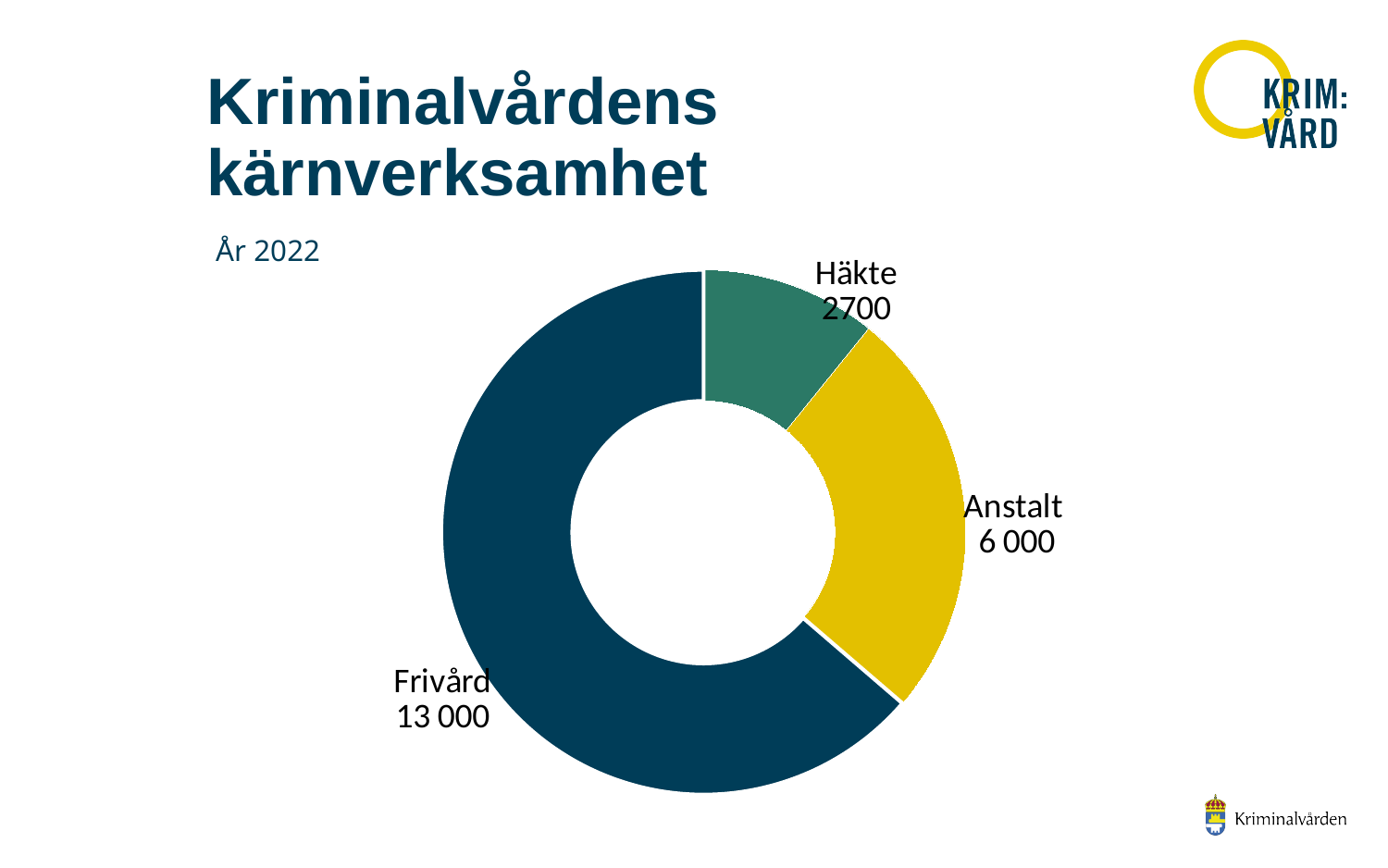
Which is larger, the value for Anstalt or the value for Häkte? Anstalt Which category has the smallest slice? Häkte What kind of chart is shown on the slide? Pie chart (donut) Which category has the largest slice? Frivård Which year does the chart refer to? 2022 What is the total of all three slices? 21 700 What is the difference between the values for Anstalt and Häkte? 3 300 What is the difference between the values for Frivård and Anstalt? 7 000 How many categories are shown in the chart? 3 What is the value for Frivård? 13 000 What is the value for Häkte? 2700 What is the value for Anstalt? 6 000